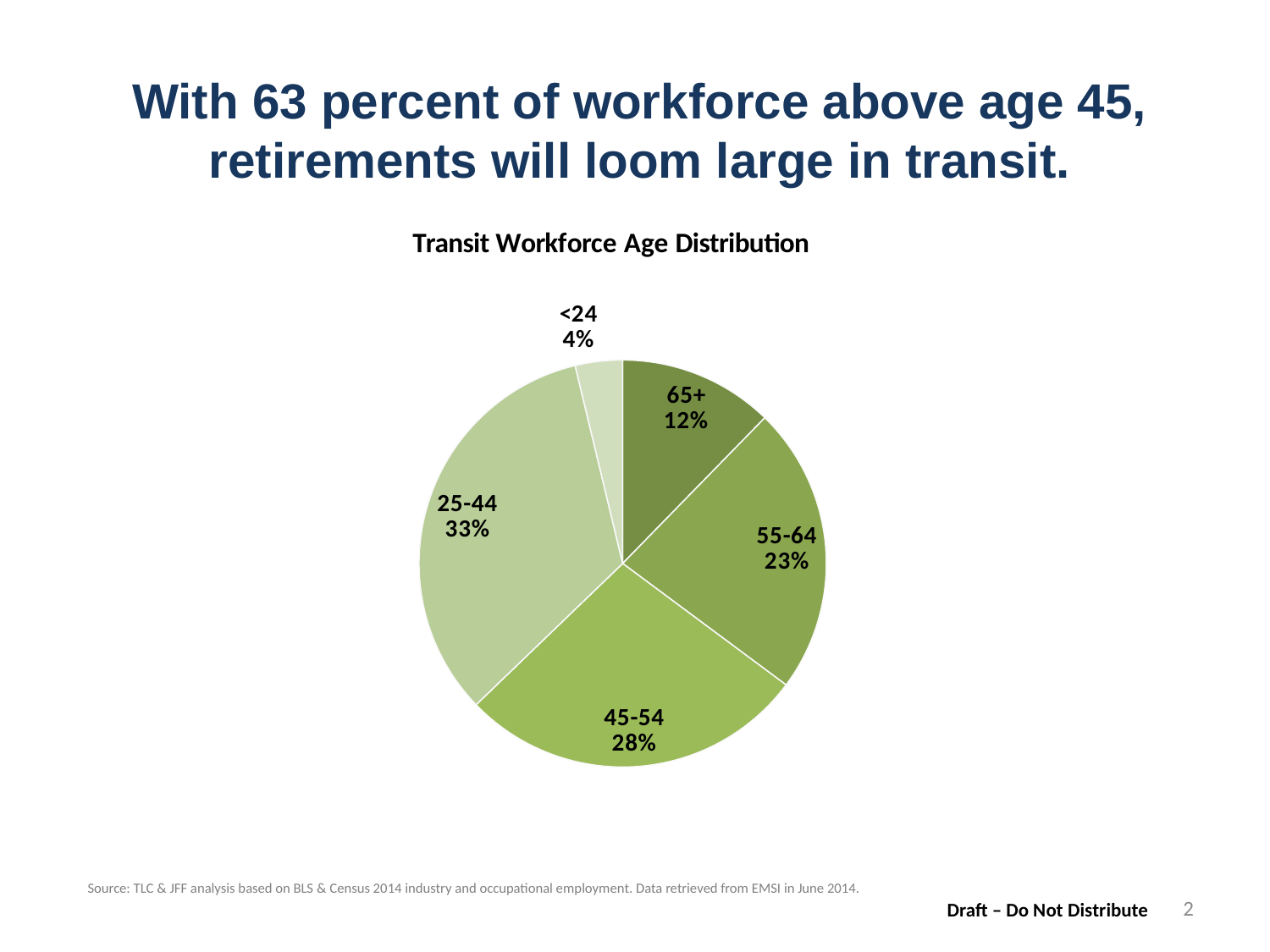
What share of the transit workforce is aged 25-44? 33% How many age groups are shown in the pie chart? 5 What is the difference in percentage points between the 45-54 and 55-64 age groups? 5 percentage points What share of the transit workforce is aged 55-64? 23% Which age group has the smallest share of the transit workforce? <24 Which age group has a larger share, 65+ or 55-64? 55-64 What share of the transit workforce is aged 65+? 12% Which age group has the largest share of the transit workforce? 25-44 What share of the transit workforce is aged 45-54? 28% What is the title of the chart? Transit Workforce Age Distribution What share of the transit workforce is under 24 (<24)? 4% What type of chart is shown on the slide? pie chart